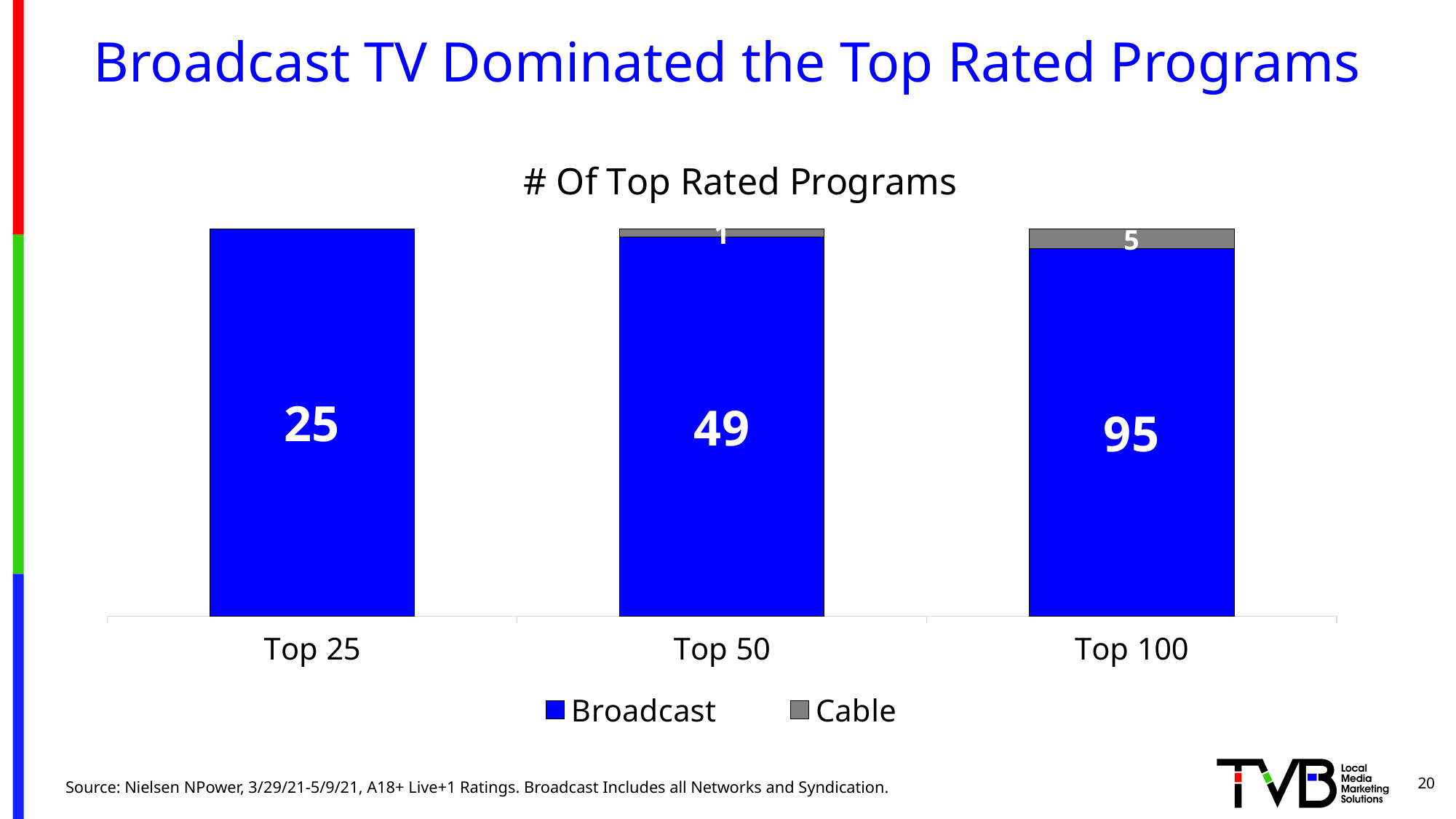
How many series does the legend list? 2 What kind of chart is shown on the slide? Stacked bar chart Which category has the lowest Broadcast value? Top 25 What is the Cable value for Top 100? 5 How many categories are shown on the x axis? 3 Which category has the highest Broadcast value? Top 100 What is the total of the stacked bar for Top 100? 100 What is the Cable value for Top 50? 1 What is the Broadcast value for Top 25? 25 What is the Broadcast value for Top 100? 95 What is the Broadcast value for Top 50? 49 What is the difference between the Broadcast values for Top 100 and Top 50? 46